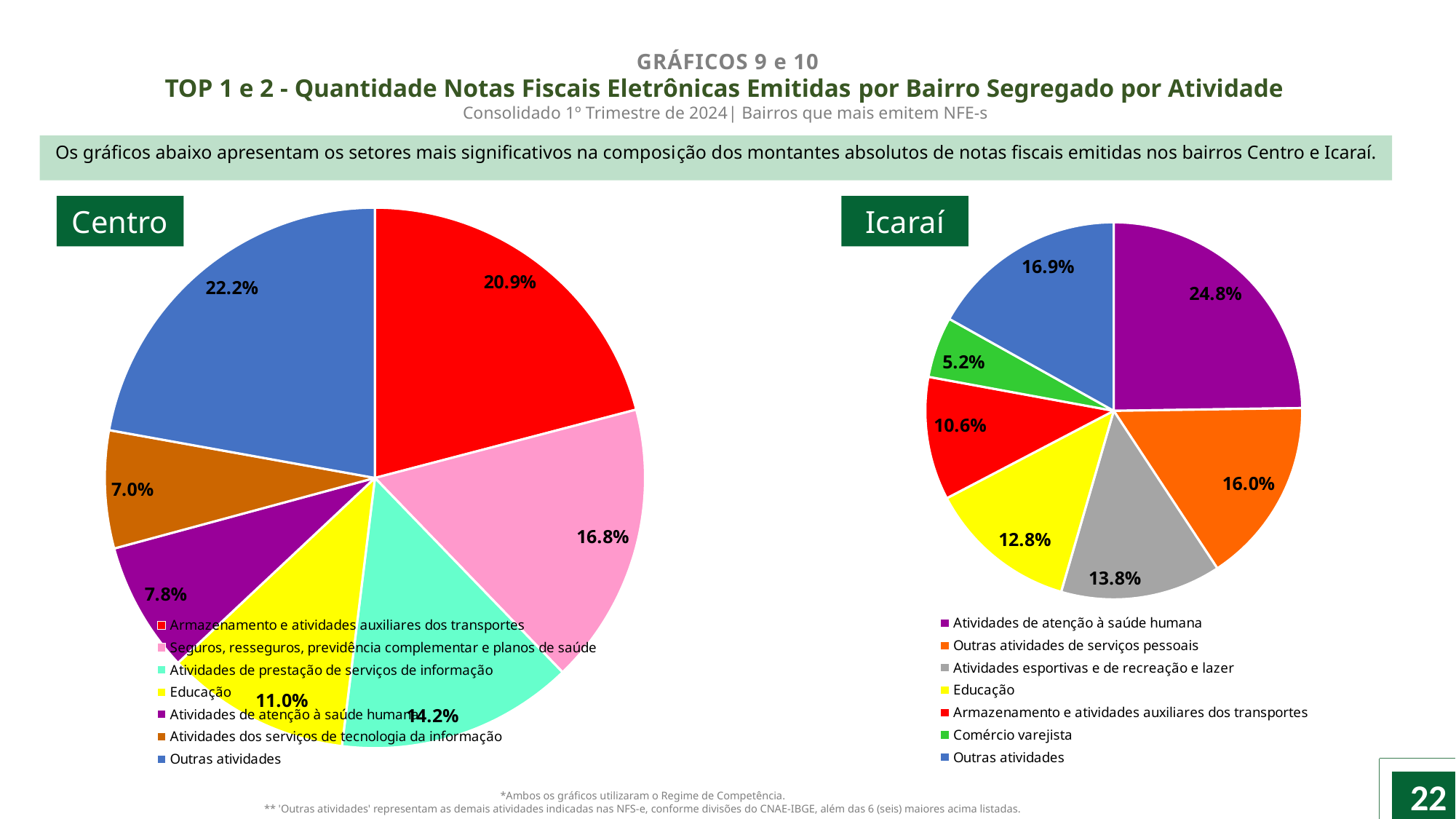
How many categories does the Icaraí pie chart show? 7 In the Centro pie chart, which category has the smallest share? Atividades dos serviços de tecnologia da informação In the Icaraí pie chart, which category has the smallest share? Comércio varejista In the Icaraí pie chart, what share does 'Atividades de atenção à saúde humana' have? 24.8% In the Icaraí pie chart, what is the difference in percentage points between 'Atividades de atenção à saúde humana' and 'Outras atividades de serviços pessoais'? 8.8 In the Centro pie chart, which category has the largest share? Outras atividades What type of chart is used for Centro? Pie chart In the Centro pie chart, what share does 'Armazenamento e atividades auxiliares dos transportes' have? 20.9% In the Centro pie chart, what share does 'Educação' have? 11.0% In the Icaraí pie chart, what colour is the 'Educação' slice? Yellow In the Icaraí pie chart, what share does 'Comércio varejista' have? 5.2% In the Centro pie chart, which is larger: 'Seguros, resseguros, previdência complementar e planos de saúde' or 'Atividades de prestação de serviços de informação'? Seguros, resseguros, previdência complementar e planos de saúde